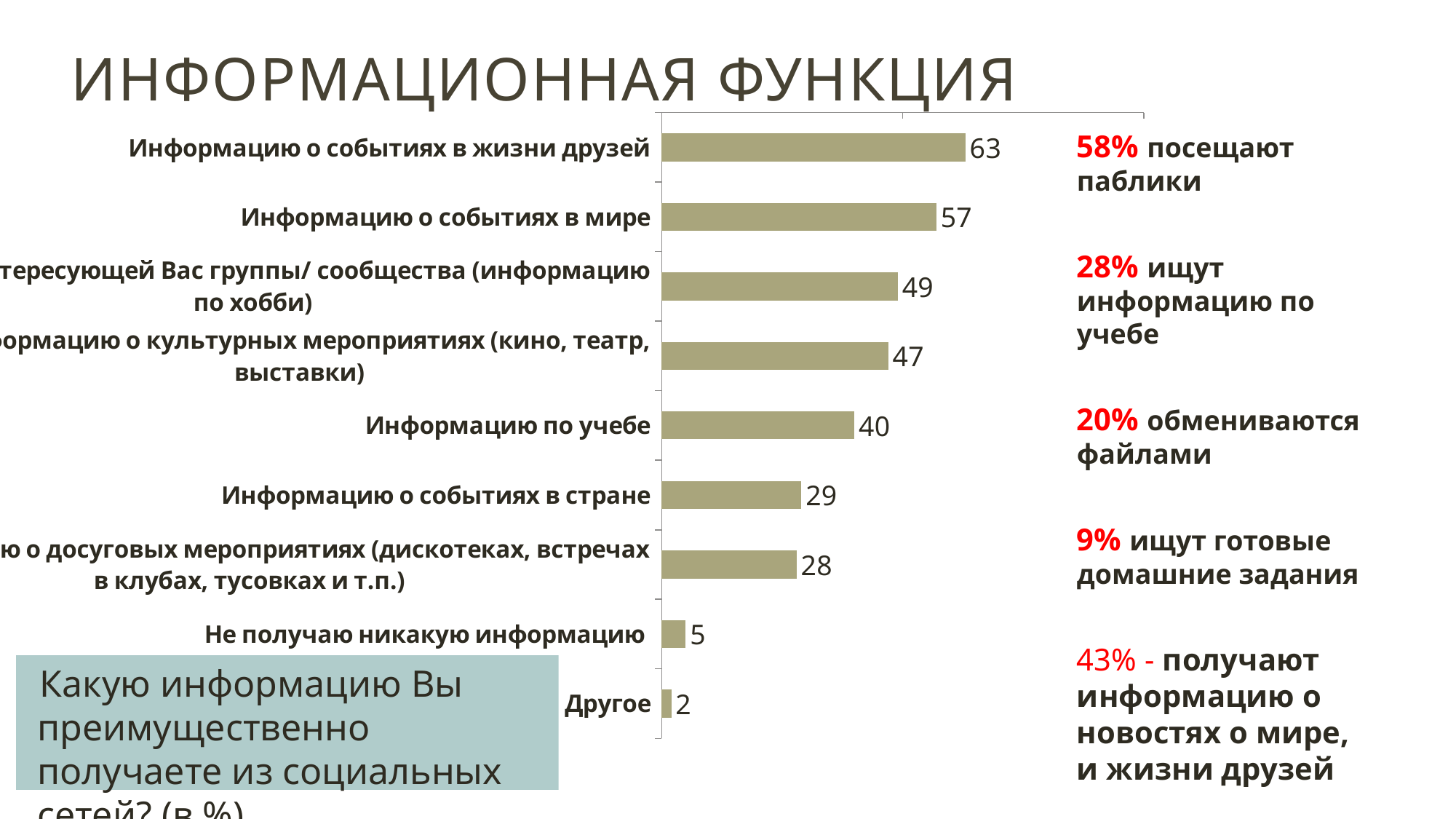
What is the difference between the values for "Информацию о событиях в жизни друзей" and "Информацию о событиях в мире"? 6 Which category has the lowest value in the chart? Другое What value is shown for "Информацию о событиях в жизни друзей"? 63 What value is shown for "Информацию по учебе"? 40 What kind of chart is shown on the slide? Bar chart What value is shown for "Не получаю никакую информацию"? 5 How many categories are shown in the chart? 9 Which is larger: the value for "Информацию о событиях в мире" or for "Информацию о событиях в стране"? Информацию о событиях в мире Which category has the highest value in the chart? Информацию о событиях в жизни друзей What value is shown for "Информацию о событиях в стране"? 29 What is the title of the slide containing the chart? ИНФОРМАЦИОННАЯ ФУНКЦИЯ What is the difference between the values for "Информацию по учебе" and "Информацию о событиях в стране"? 11